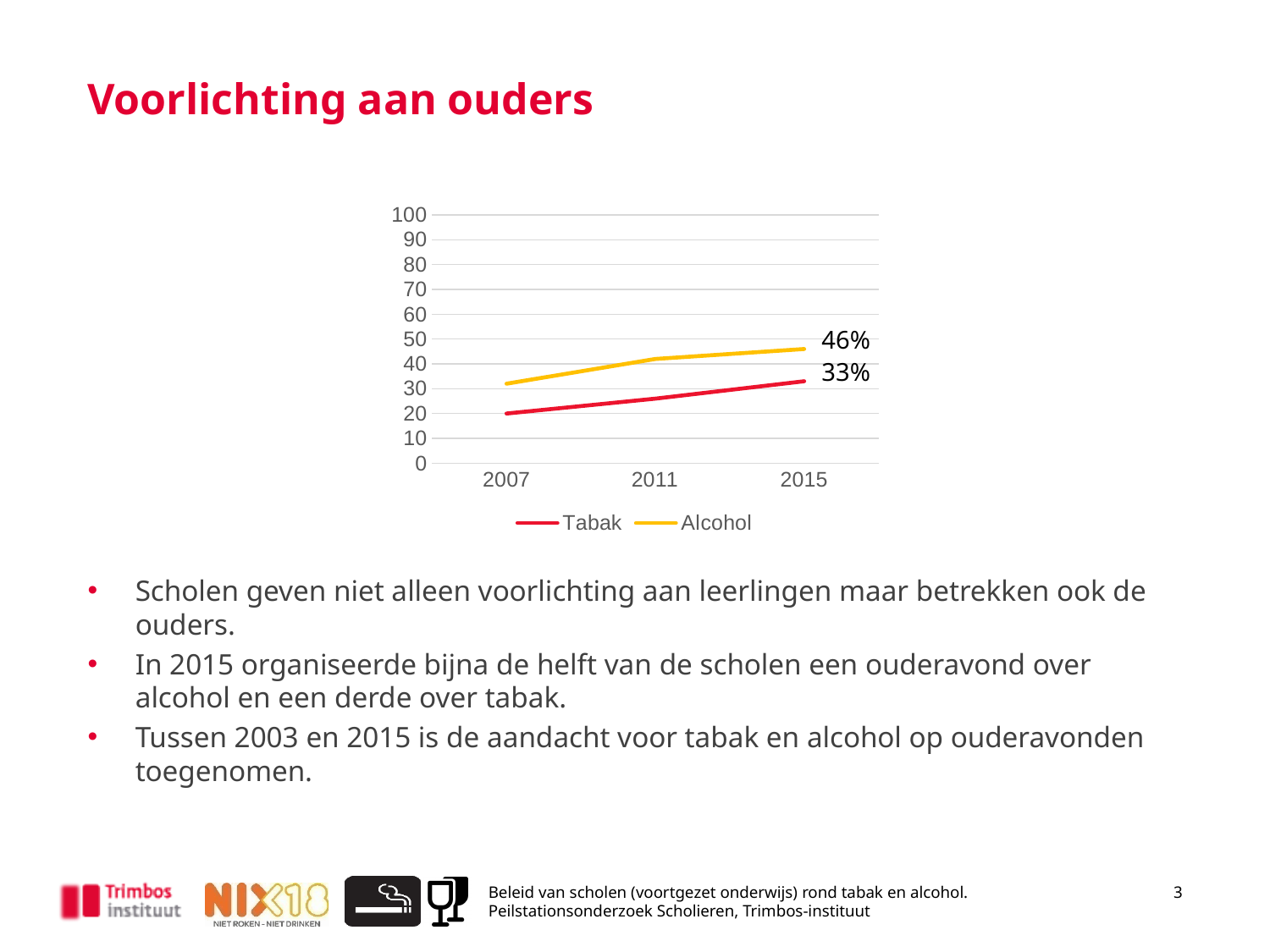
Is the value for Alcohol in 2011 greater or less than 30? greater What is the value for Tabak in 2015? 33% How many years are shown on the x axis? 3 Which colour is used for the Alcohol line? Yellow Which series has the higher value in 2015, Tabak or Alcohol? Alcohol Is the value for Tabak in 2007 greater or less than 30? less Does the Tabak line rise or fall from 2007 to 2015? Rise What is the difference between the Alcohol and Tabak values in 2015? 13 percentage points How many series does the legend list? 2 Is the value for Alcohol in 2007 greater or less than 50? less What is the value for Alcohol in 2015? 46% What kind of chart is shown on the slide? Line chart